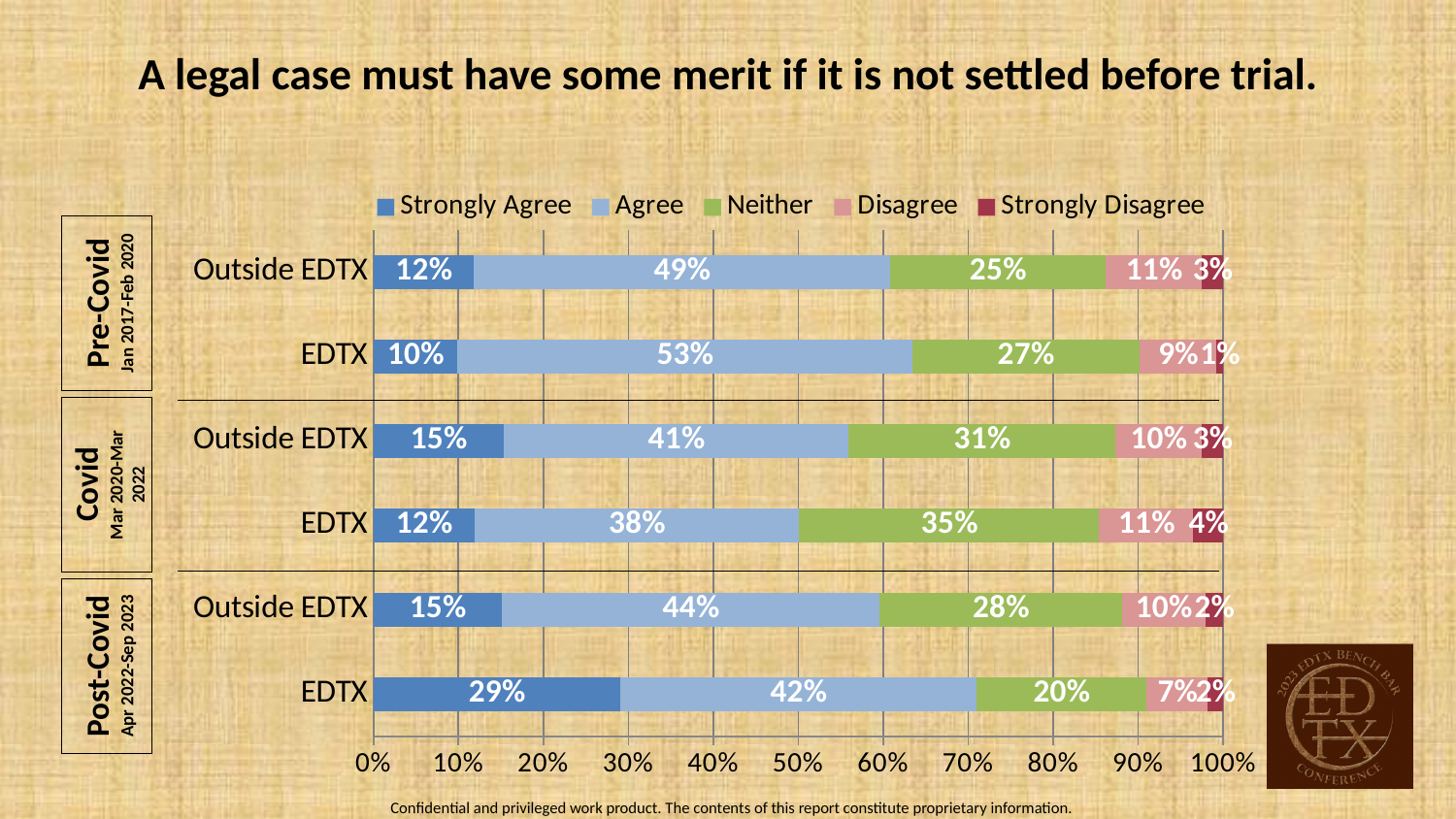
What is the Strongly Agree value for EDTX in the Post-Covid period? 29% What kind of chart is shown on the slide? Stacked bar chart Which is larger: the Neither value for Outside EDTX in the Covid period or the Neither value for Outside EDTX in the Post-Covid period? Outside EDTX in the Covid period Which bar has the highest Strongly Agree value? Post-Covid EDTX How many bars are plotted in the chart? 6 What is the difference between the Strongly Agree values for EDTX in the Post-Covid period and EDTX in the Covid period? 17% How many series does the legend list? 5 What is the Neither value for EDTX in the Covid period? 35% What is the Disagree value for Outside EDTX in the Pre-Covid period? 11% What is the combined Strongly Agree and Agree share for EDTX in the Post-Covid period? 71% Which bar has the lowest Strongly Disagree value? Pre-Covid EDTX What is the Agree value for EDTX in the Pre-Covid period? 53%